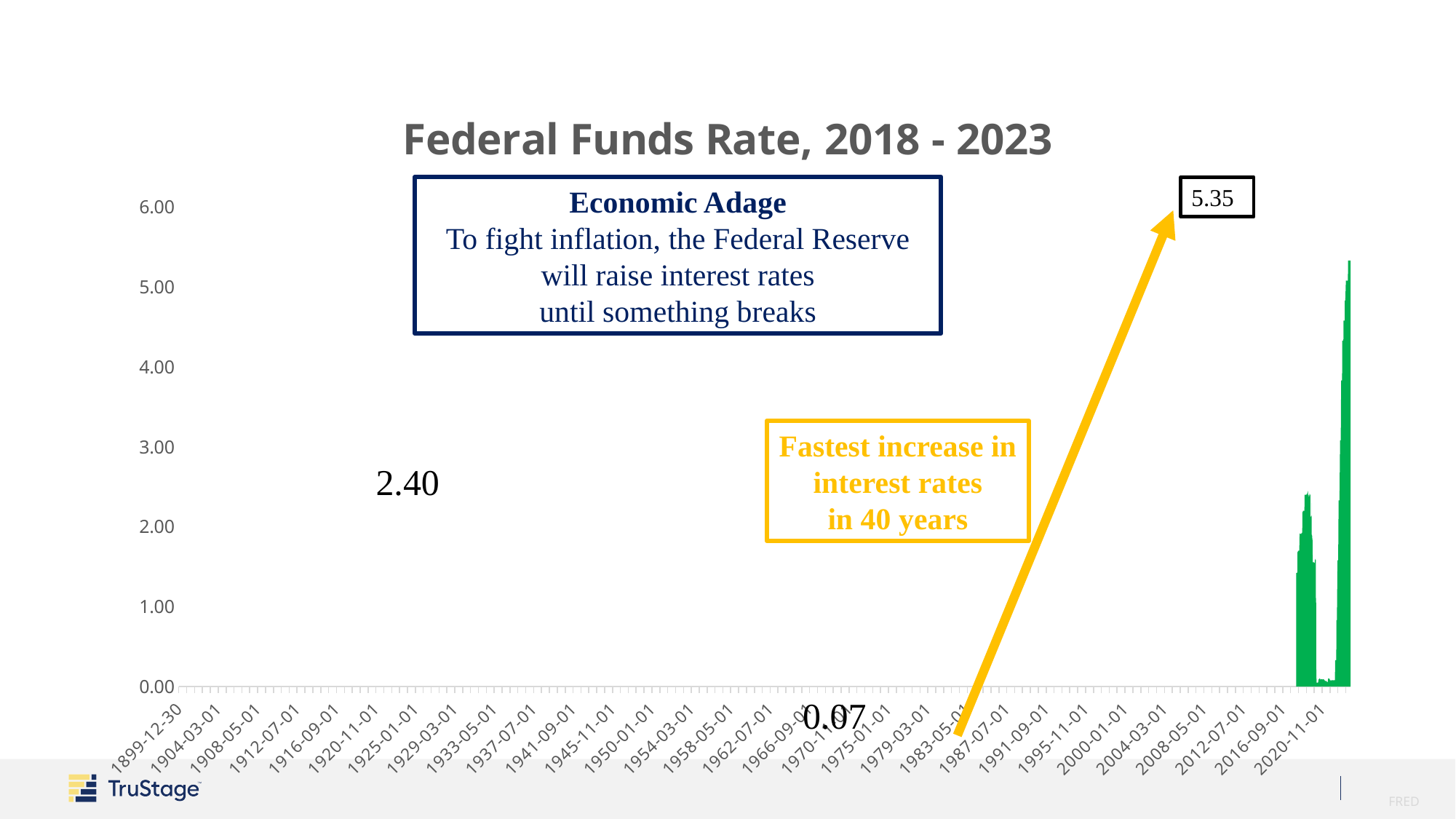
What value is labelled for the earlier, smaller peak of the Federal Funds Rate? 2.40 Is the final peak of the Federal Funds Rate greater or less than 5.00? greater What is the difference between the labelled values 5.35 and 2.40? 2.95 From the labelled low of 0.07 to the end of the series, does the Federal Funds Rate rise or fall? rise What is the highest value labelled on the chart? 5.35 How many data values are labelled on the chart? 3 What does the yellow annotation box on the chart say? Fastest increase in interest rates in 40 years What is the difference between the labelled peak value of 5.35 and the labelled low of 0.07? 5.28 What is the title of the chart? Federal Funds Rate, 2018 - 2023 Which labelled value is larger, 2.40 or 5.35? 5.35 What is the lowest value labelled on the chart? 0.07 Is the earlier peak of the Federal Funds Rate greater or less than 3.00? less